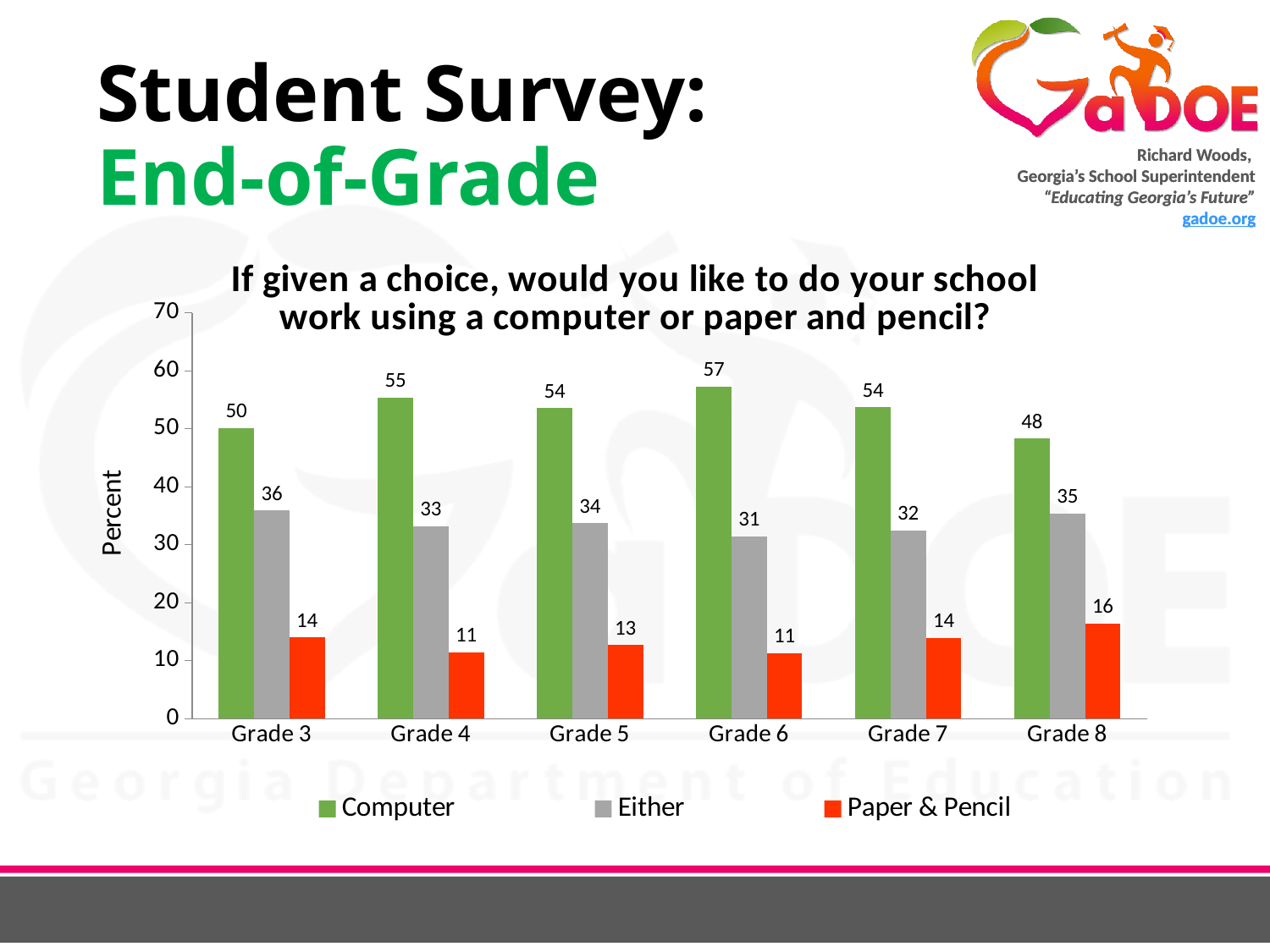
How many grades are shown on the x axis? 6 What is the value for Paper & Pencil in Grade 8? 16 What kind of chart is shown on the slide? bar chart How many series does the legend list? 3 Is the Computer value for Grade 5 greater or less than 50? greater Which grade has the highest Computer value? Grade 6 What is the value for Either in Grade 3? 36 What is the difference between the Computer and Either values for Grade 4? 22 What percent of Grade 6 students chose Computer? 57 Which is larger for Grade 7: the Either value or the Paper & Pencil value? Either What is the label of the y axis? Percent Which grade has the lowest Computer value? Grade 8